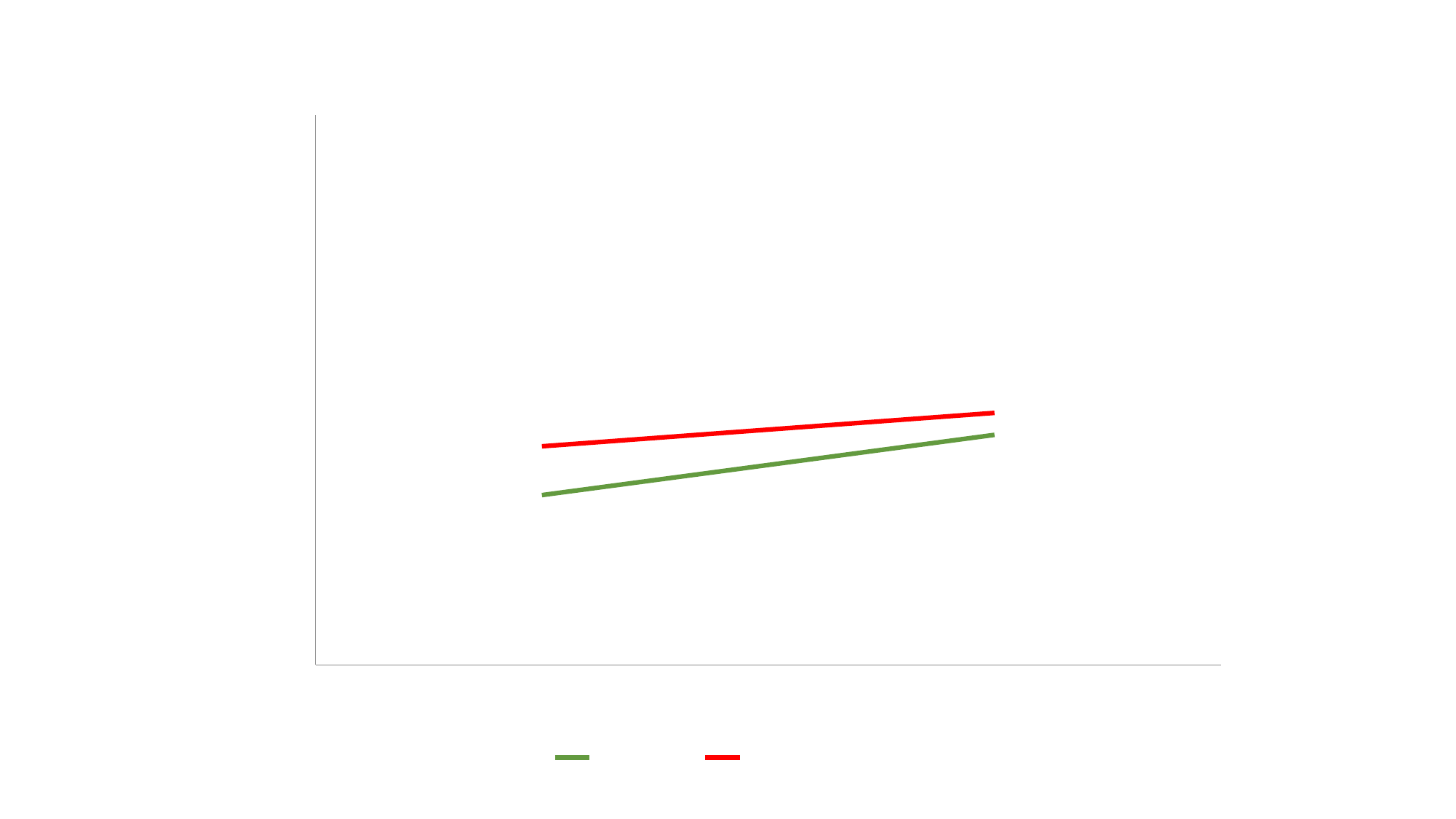
Which line rises more steeply from left to right, the green line or the red line? the green line Do the values of the green line rise or fall from left to right? rise What kind of chart is shown on the slide? line chart How many points does each line connect? 2 What colours are the two lines on the chart? green and red Which line is plotted higher on the chart, the red line or the green line? the red line Do the values of the red line rise or fall from left to right? rise How many series does the legend list? 2